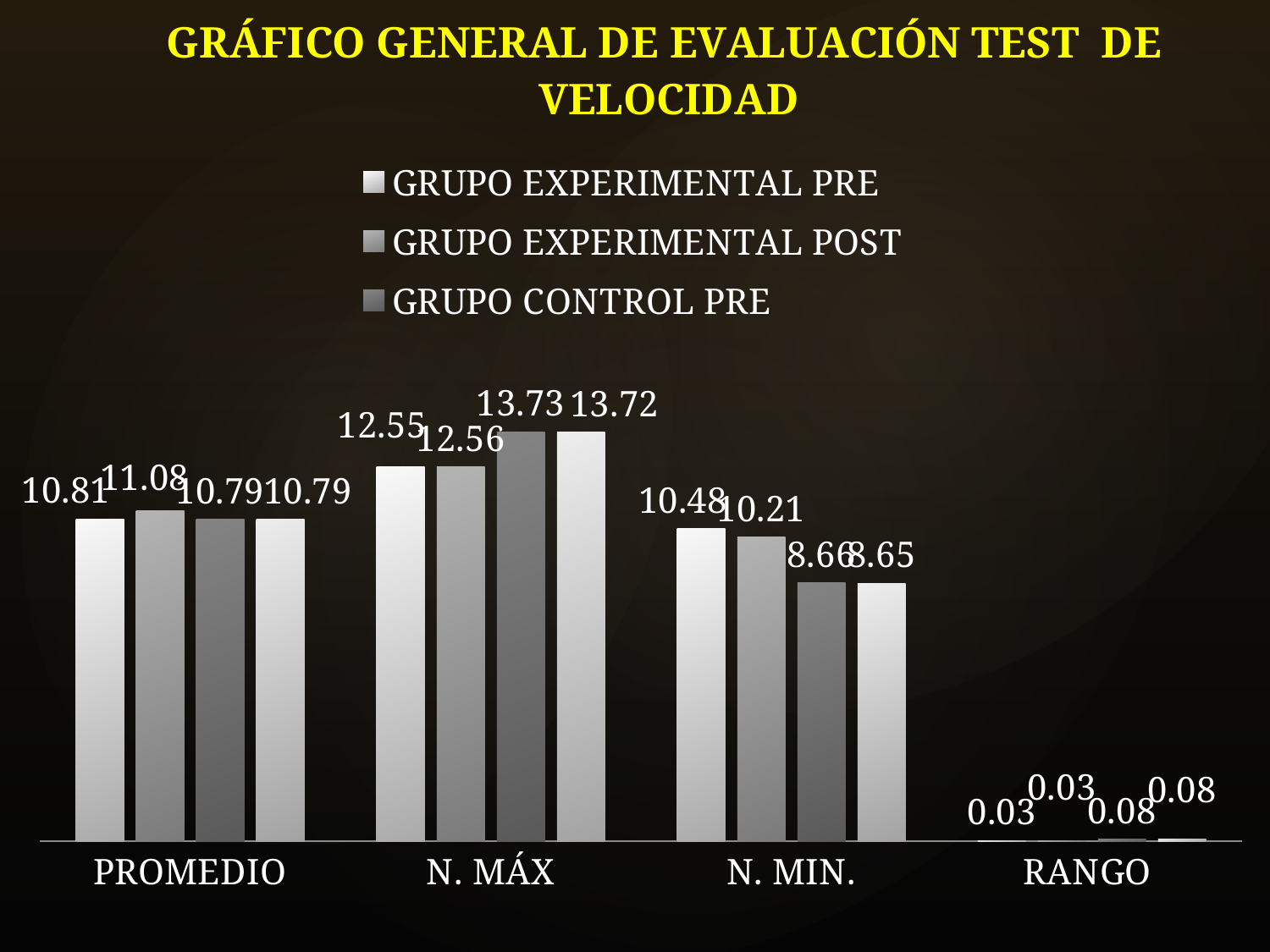
In the PROMEDIO category, how much higher is GRUPO EXPERIMENTAL POST than GRUPO EXPERIMENTAL PRE? 0.27 What is the value for GRUPO CONTROL PRE in the N. MIN. category? 8.66 How many series does the legend list? 3 What is the value for GRUPO EXPERIMENTAL PRE in the RANGO category? 0.03 In the N. MIN. category, what is the difference between GRUPO EXPERIMENTAL PRE and GRUPO CONTROL PRE? 1.82 In which category does GRUPO EXPERIMENTAL POST have its lowest value? RANGO In which category does GRUPO CONTROL PRE have its highest value? N. MÁX In the N. MÁX category, which is larger: GRUPO CONTROL PRE or GRUPO EXPERIMENTAL PRE? GRUPO CONTROL PRE How many categories are shown on the x axis? 4 What kind of chart is shown on the slide? Bar chart What is the value for GRUPO EXPERIMENTAL PRE in the PROMEDIO category? 10.81 What is the value for GRUPO EXPERIMENTAL POST in the N. MÁX category? 12.56